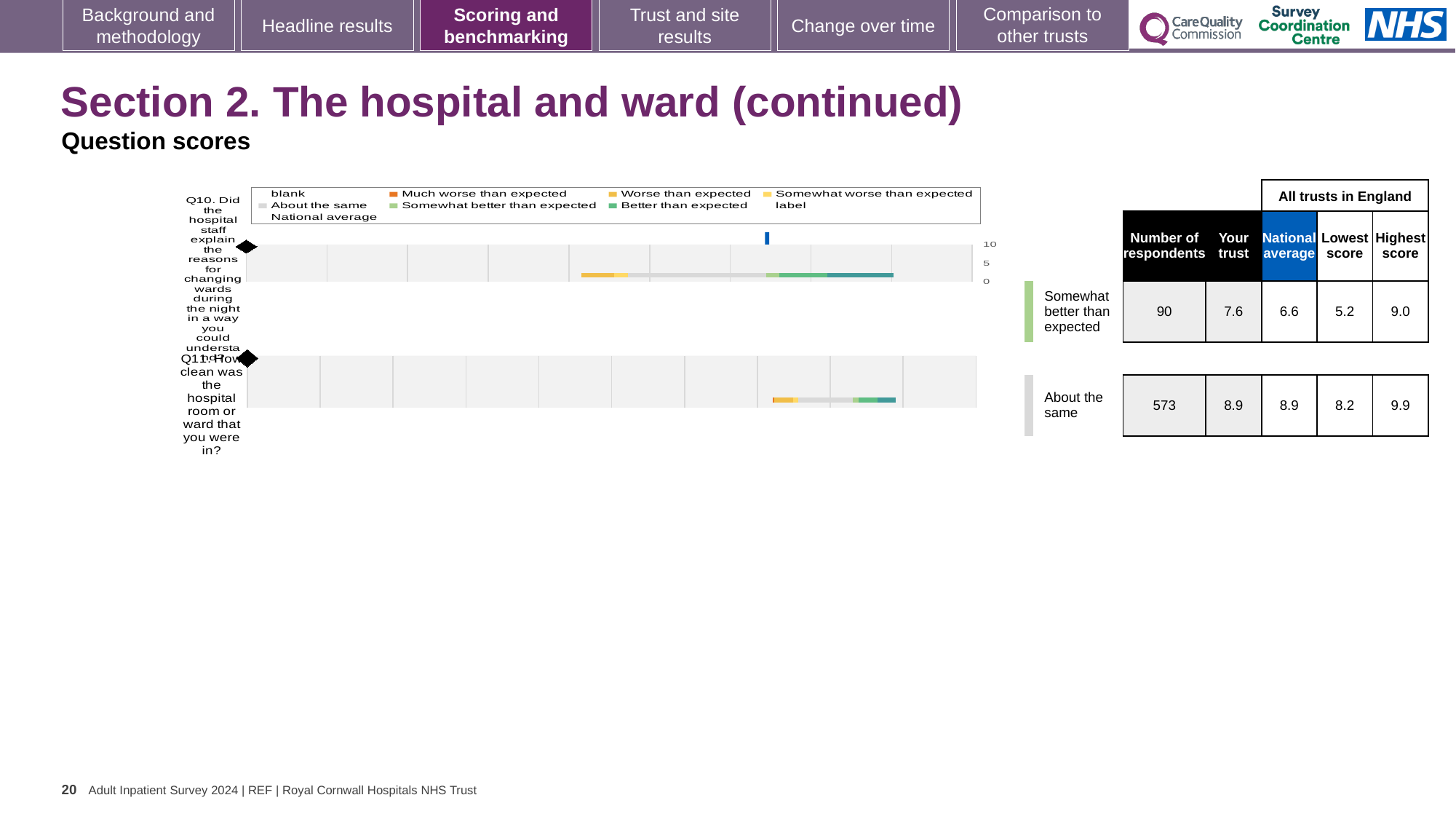
Which benchmark category is Q11 rated as? About the same What is the difference between the 'Your trust' score and the national average for Q10? 1.0 How many survey questions are plotted in the chart? 2 What is the highest score among all trusts in England for Q11? 9.9 How many respondents answered Q11 (how clean was the hospital room or ward)? 573 Which benchmark category is Q10 rated as? Somewhat better than expected What is the difference between the highest and lowest scores for Q11? 1.7 What is the maximum value shown on the chart's score axis? 10 For Q10, which is larger: the 'Your trust' score or the national average? Your trust What is the national average score for Q10? 6.6 What kind of chart is used to show the question scores on this slide? bar chart What is the 'Your trust' score for Q10 (explaining reasons for changing wards during the night)? 7.6